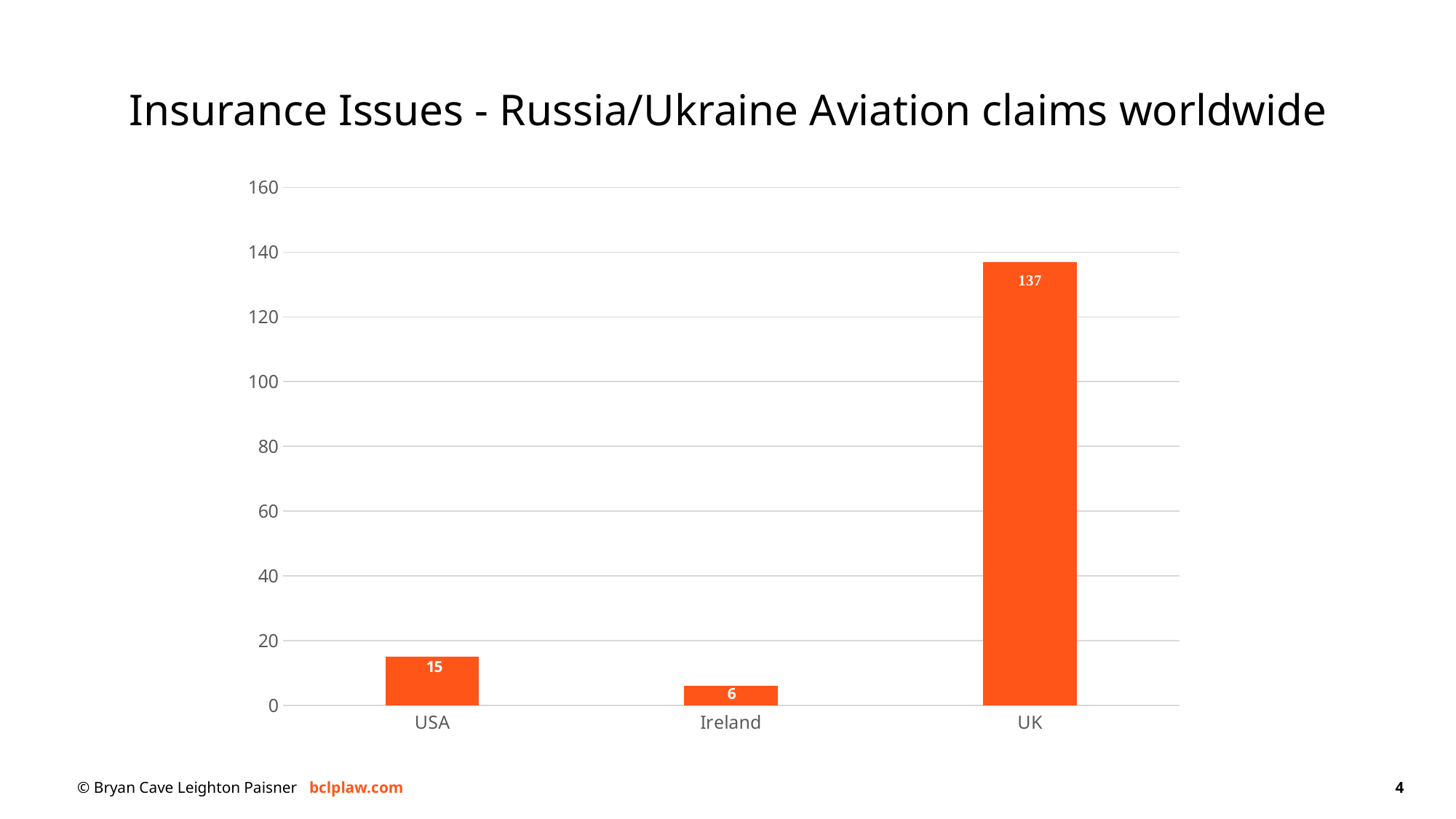
What is the value for the USA? 15 Which is larger, the value for the USA or the value for Ireland? USA How many categories are shown on the x axis? 3 What is the value for Ireland? 6 Is the value for the UK greater or less than 120? greater What is the value for the UK? 137 What is the difference between the values for the USA and Ireland? 9 What is the difference between the values for the UK and the USA? 122 What is the title of the slide? Insurance Issues - Russia/Ukraine Aviation claims worldwide Which category has the lowest value? Ireland Which category has the highest value? UK What kind of chart is shown on the slide? bar chart